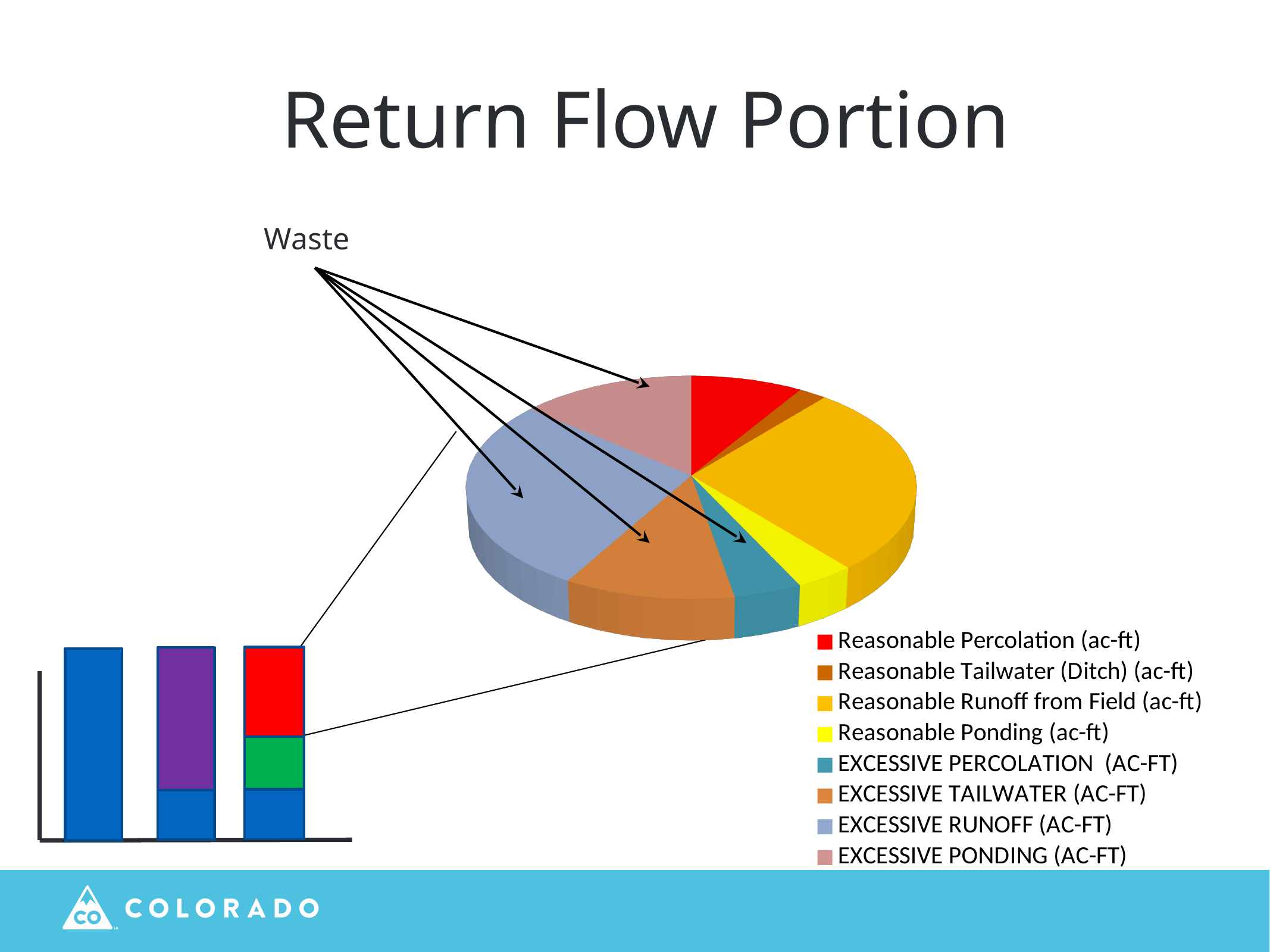
In the pie chart, which slice is larger: Reasonable Runoff from Field (ac-ft) or Reasonable Ponding (ac-ft)? Reasonable Runoff from Field (ac-ft) How many categories does the legend of the pie chart list? 8 Which category has the smallest slice in the pie chart? Reasonable Tailwater (Ditch) (ac-ft) What is the title of the slide containing the pie chart? Return Flow Portion In the pie chart, which slice is larger: Reasonable Percolation (ac-ft) or Reasonable Ponding (ac-ft)? Reasonable Percolation (ac-ft) In the pie chart, which slice is larger: EXCESSIVE TAILWATER (AC-FT) or EXCESSIVE PERCOLATION (AC-FT)? EXCESSIVE TAILWATER (AC-FT) How many slices of the pie chart do the arrows from the label "Waste" point to? 4 What kind of chart is the small chart in the bottom-left corner of the slide? Bar chart What kind of chart is the large chart in the centre of the slide? Pie chart What colour is used for Reasonable Ponding (ac-ft) in the pie chart? Yellow How many bars are in the small bar chart in the bottom-left corner of the slide? 3